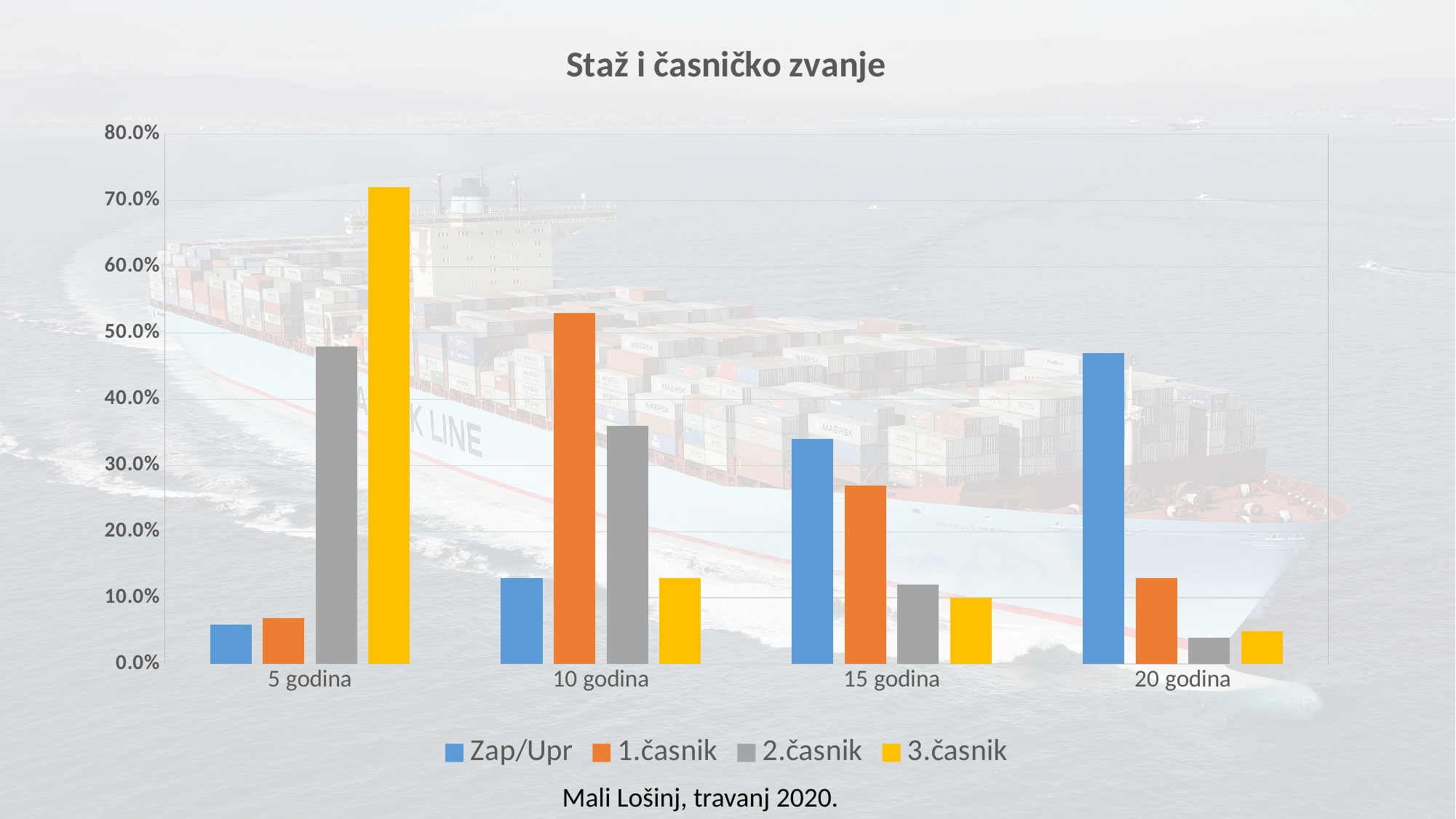
Is the value for 1.časnik at 10 godina greater or less than 50.0%? greater How many series does the legend list? 4 How many categories are shown on the x axis of the chart? 4 Which series has the highest value for 5 godina? 3.časnik What is the title of the chart? Staž i časničko zvanje Is the value for Zap/Upr at 20 godina greater or less than 50.0%? less Do the values for Zap/Upr rise or fall from 5 godina to 20 godina? rise Which series has the highest value for 10 godina? 1.časnik What kind of chart is shown on the slide? bar chart Do the values for 3.časnik rise or fall from 5 godina to 20 godina? fall Which series has the highest value for 20 godina? Zap/Upr Is the value for 3.časnik at 5 godina greater or less than 70.0%? greater